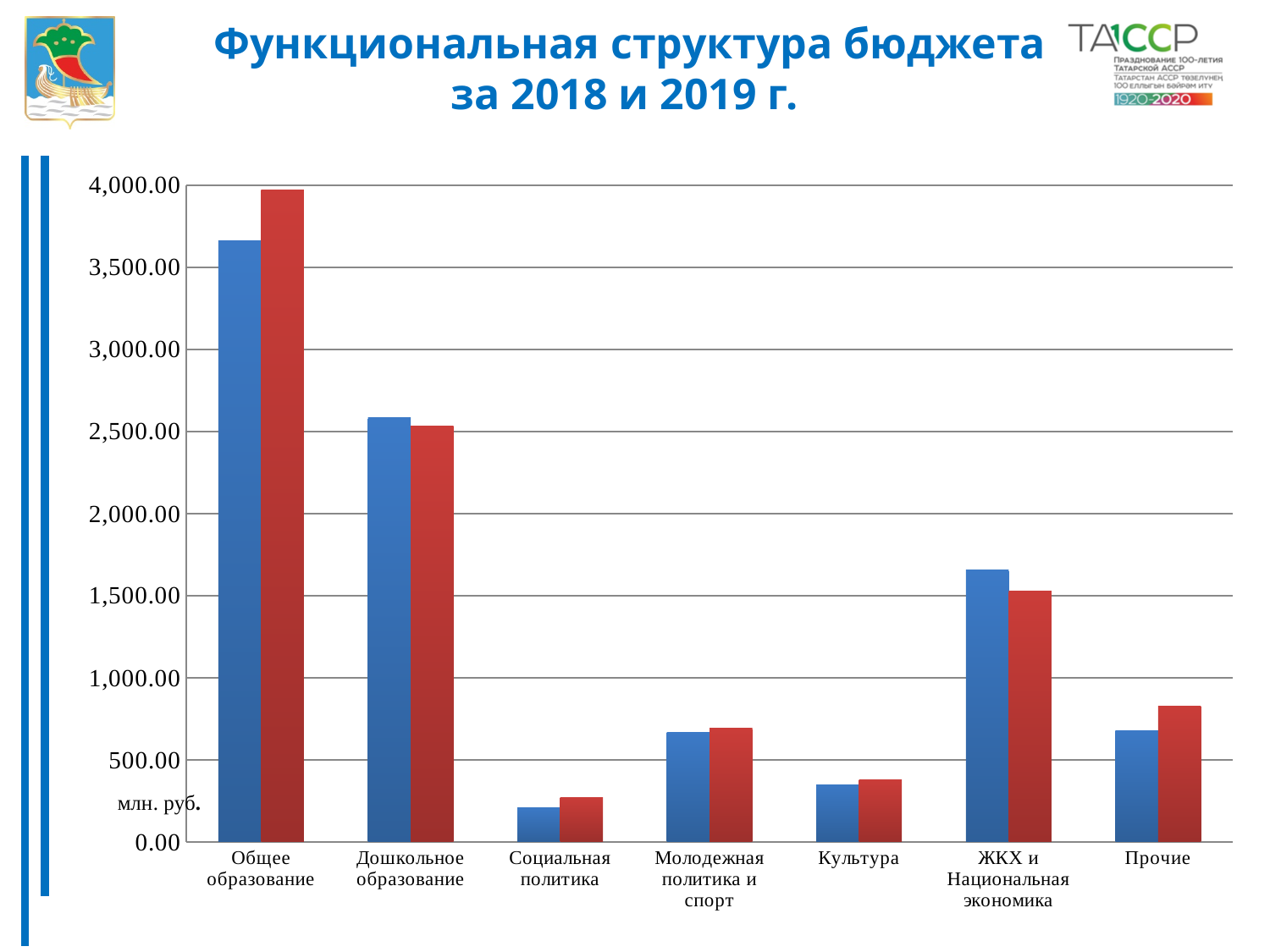
How many categories are shown along the x axis of the chart? 7 Is the value of the red bar for Культура greater or less than 500.00? less Is the value of the blue bar for Социальная политика greater or less than 500.00? less Is the value of the blue bar for ЖКХ и Национальная экономика greater or less than 1,500.00? greater For Общее образование, which bar is taller, the blue one or the red one? the red one Which category has the tallest bars in the chart? Общее образование Which category has the shortest bars in the chart? Социальная политика What kind of chart is shown on the slide? bar chart For ЖКХ и Национальная экономика, which bar is taller, the blue one or the red one? the blue one What unit is indicated on the chart's value axis? млн. руб.